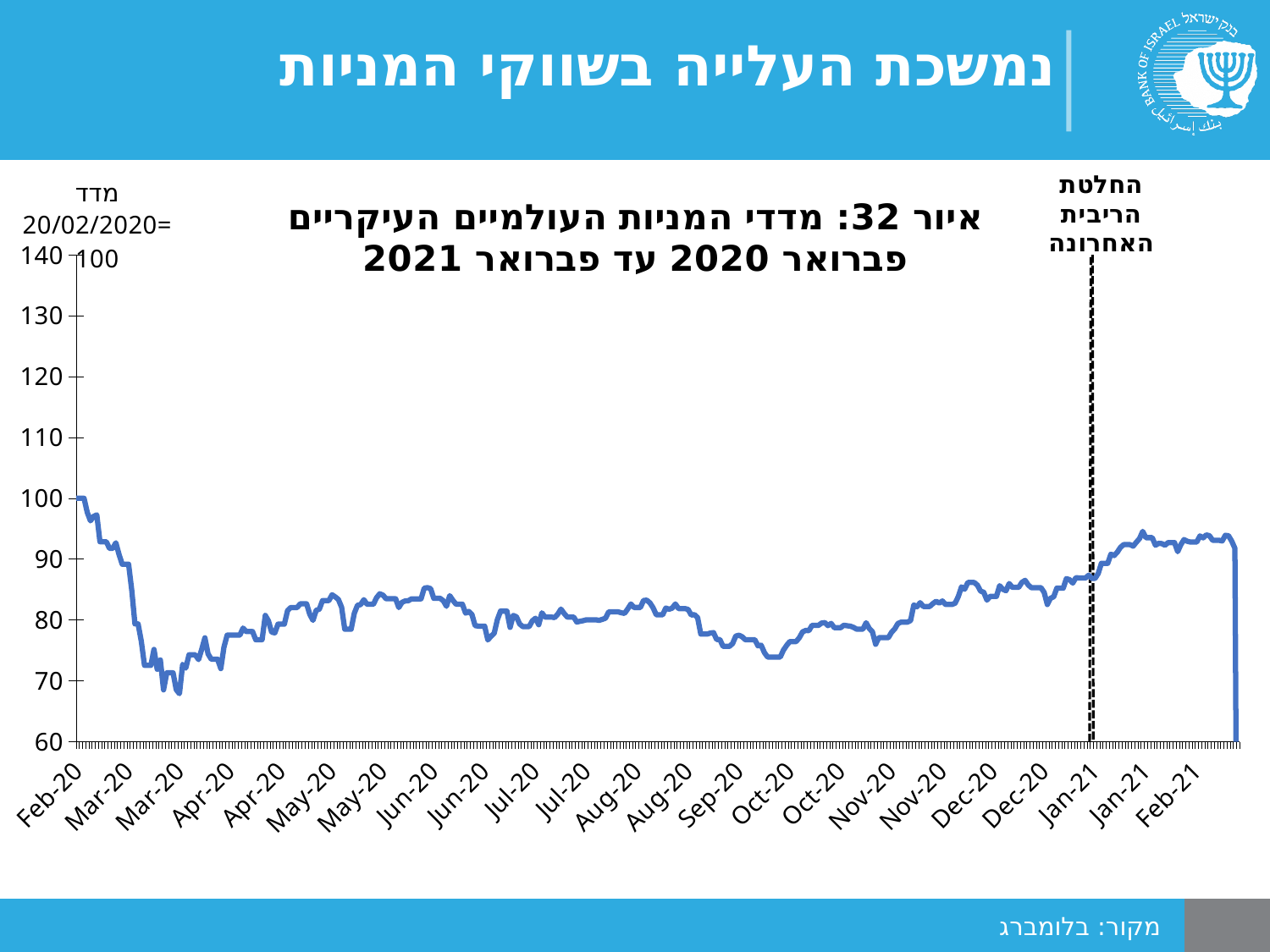
What is the index value at the start of the series on 20/02/2020? 100 Does the index rise or fall between Oct-20 and Jan-21? rise What does the dashed vertical line on the chart mark? החלטת הריבית האחרונה Is the value of the index in early Oct-20 greater or less than 80? less What kind of chart is shown on the slide? line chart What is the title of the chart? איור 32: מדדי המניות העולמיים העיקריים פברואר 2020 עד פברואר 2021 Does the index rise or fall between Feb-20 and Mar-20? fall Which is higher, the index value in Jan-21 or in Oct-20? Jan-21 Is the lowest value of the index in Mar-20 greater or less than 70? less How many lines are plotted on the chart? 1